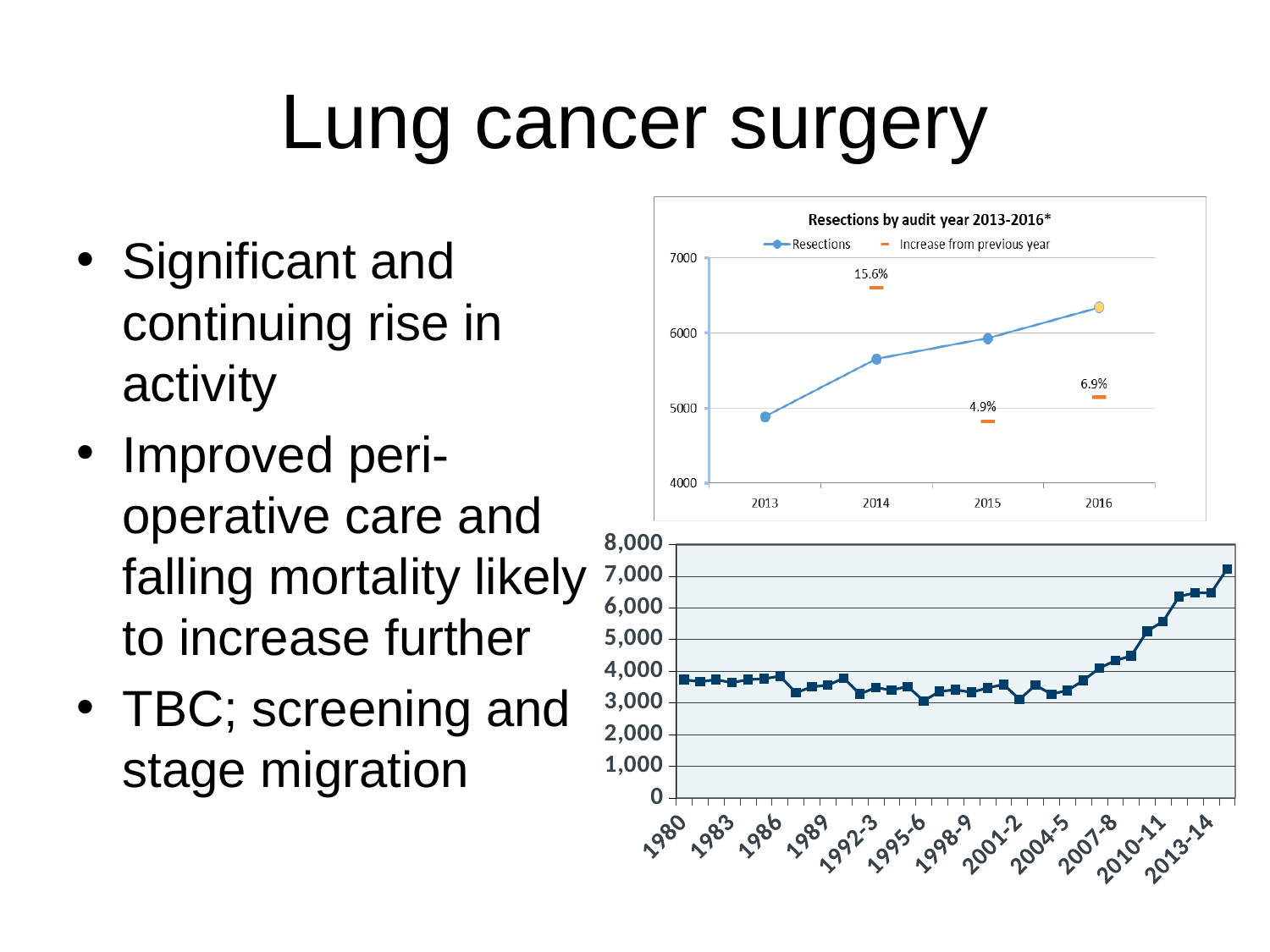
In the top chart 'Resections by audit year 2013-2016*', what is the increase from the previous year shown for 2016? 6.9% In the top chart 'Resections by audit year 2013-2016*', which year has the highest increase from the previous year? 2014 In the top chart 'Resections by audit year 2013-2016*', what is the increase from the previous year shown for 2015? 4.9% In the top chart 'Resections by audit year 2013-2016*', how many series does the legend list? 2 In the top chart 'Resections by audit year 2013-2016*', which year has the lowest increase from the previous year? 2015 In the bottom chart with years from 1980 to 2013-14, is the value for 2013-14 greater or less than 6,000? greater In the top chart 'Resections by audit year 2013-2016*', do the resections rise or fall from 2013 to 2016? rise In the top chart 'Resections by audit year 2013-2016*', is the number of resections in 2016 greater or less than 6000? greater In the top chart 'Resections by audit year 2013-2016*', what is the increase from the previous year shown for 2014? 15.6% In the top chart 'Resections by audit year 2013-2016*', how many years are plotted on the x axis? 4 What kind of chart is the top chart titled 'Resections by audit year 2013-2016*'? line chart What kind of chart is the bottom chart with years from 1980 to 2013-14 on the x axis? line chart